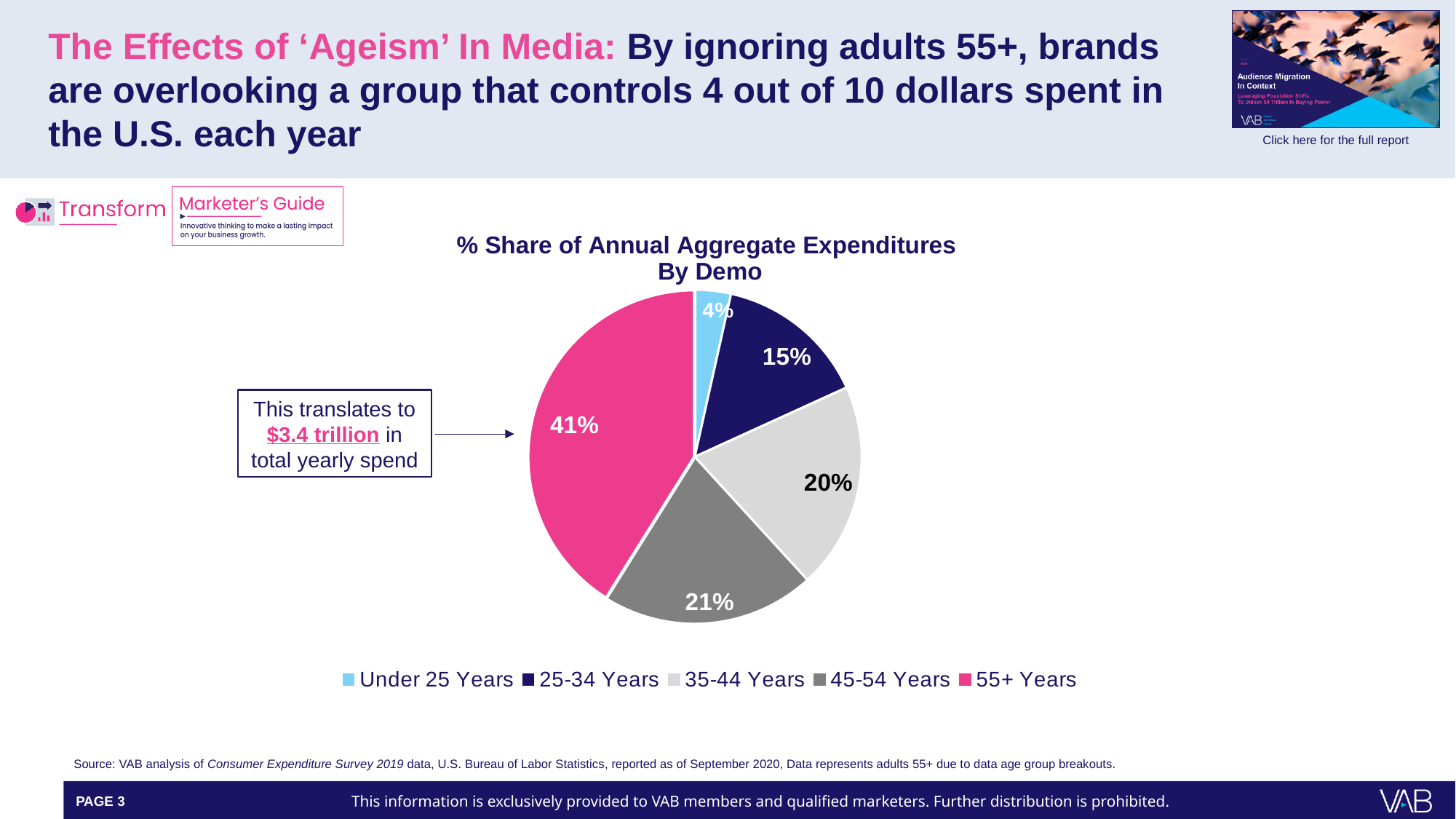
What is the difference in share between the 55+ Years group and the 35-44 Years group? 21 percentage points What colour is the slice representing the 55+ Years group? Pink What share of annual aggregate expenditures is attributed to the 45-54 Years group? 21% Which age group has the smallest share of annual aggregate expenditures? Under 25 Years Which has a larger share of expenditures, the 25-34 Years group or the 45-54 Years group? 45-54 Years What share of annual aggregate expenditures is attributed to the 55+ Years group? 41% How many age groups are shown in the pie chart? 5 Which age group has the largest share of annual aggregate expenditures? 55+ Years What share of annual aggregate expenditures is attributed to the 25-34 Years group? 15% What is the title of the chart? % Share of Annual Aggregate Expenditures By Demo What type of chart is shown on the slide? Pie chart What share of annual aggregate expenditures is attributed to the Under 25 Years group? 4%